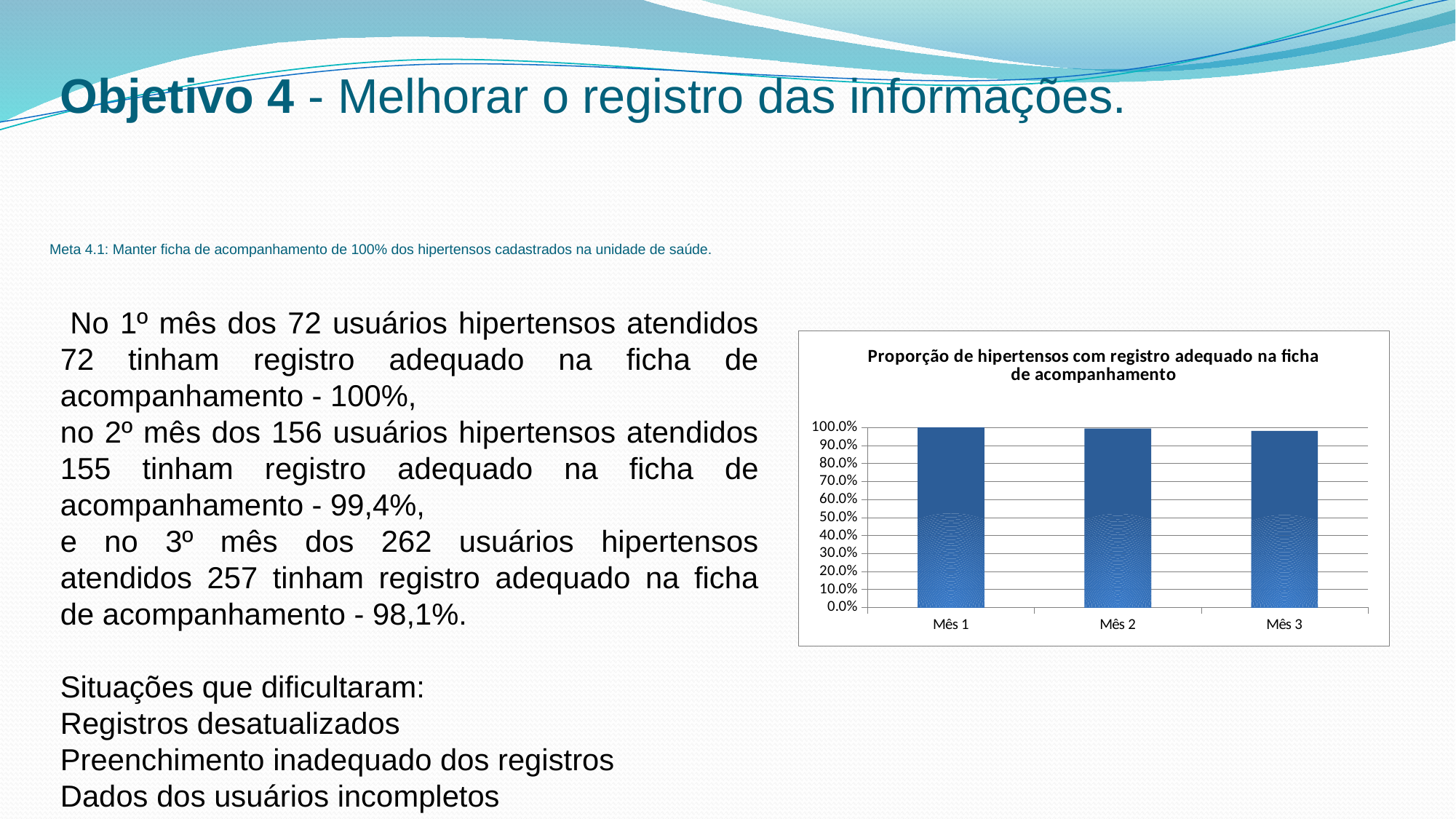
What is the label of the first category on the x axis? Mês 1 What is the value for Mês 1 on the chart? 100.0% What is the title of the chart? Proporção de hipertensos com registro adequado na ficha de acompanhamento What is the highest value shown on the chart's vertical axis? 100.0% How many categories (months) are plotted on the chart? 3 What is the label of the last category on the x axis? Mês 3 Is the value for Mês 3 greater or less than 50.0%? greater Is the value for Mês 2 greater or less than 90.0%? greater Is the value for Mês 3 greater or less than 80.0%? greater What kind of chart is shown on the slide? bar chart